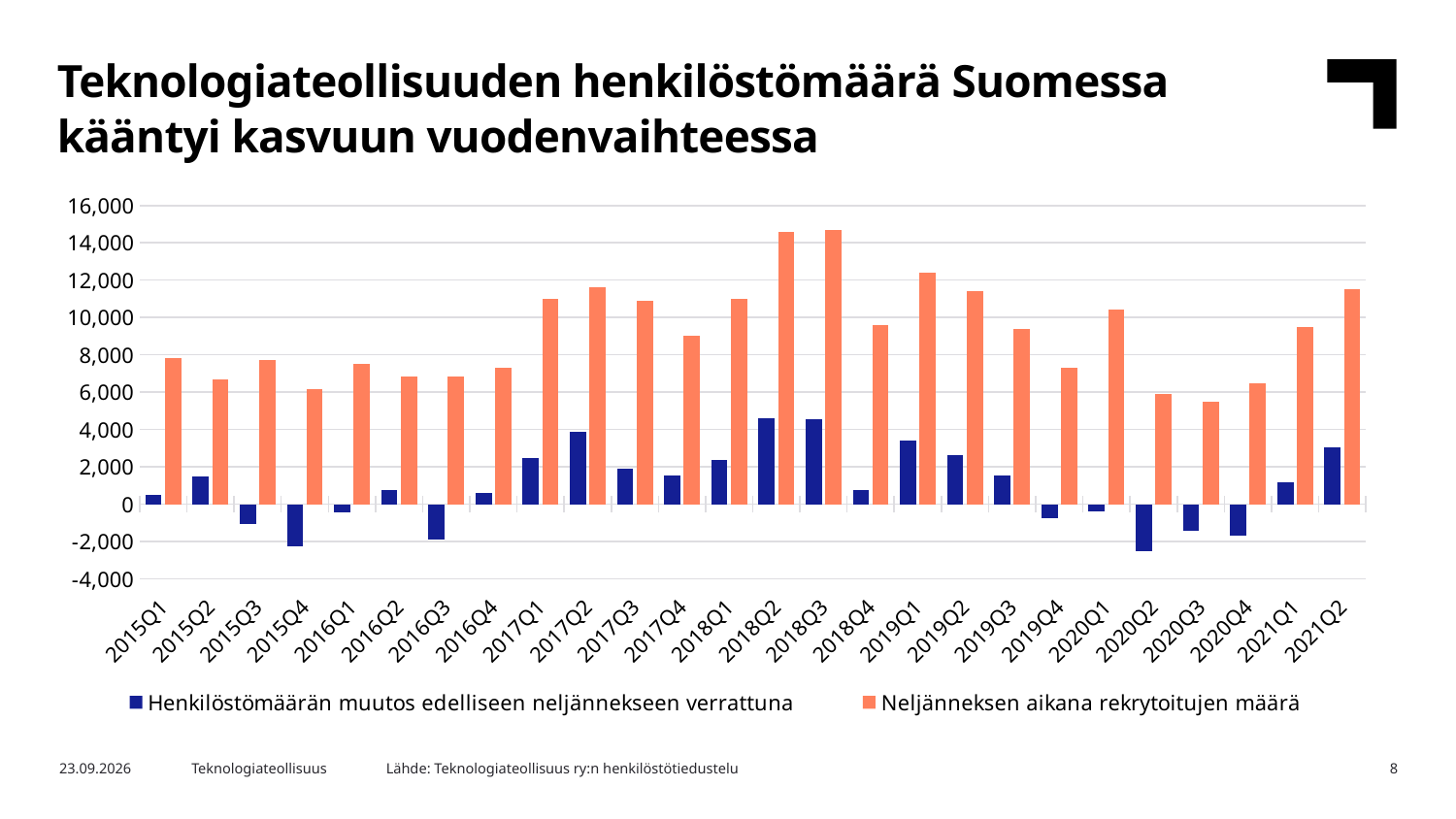
What colour are the bars for 'Neljänneksen aikana rekrytoitujen määrä'? orange Is the value for 'Henkilöstömäärän muutos edelliseen neljännekseen verrattuna' in 2017Q2 greater or less than 2,000? greater How many series does the legend list? 2 Is the value for 'Neljänneksen aikana rekrytoitujen määrä' in 2018Q2 greater or less than 14,000? greater How many quarters are shown on the x axis? 26 What kind of chart is shown on the slide? bar chart Is the value for 'Henkilöstömäärän muutos edelliseen neljännekseen verrattuna' in 2020Q2 greater or less than -2,000? less Does the value for 'Neljänneksen aikana rekrytoitujen määrä' rise or fall from 2020Q3 to 2021Q2? rise Which quarter has the lowest value for 'Henkilöstömäärän muutos edelliseen neljännekseen verrattuna'? 2020Q2 Which quarter has the larger value for 'Neljänneksen aikana rekrytoitujen määrä', 2019Q1 or 2019Q2? 2019Q1 Which quarter has the lowest value for 'Neljänneksen aikana rekrytoitujen määrä'? 2020Q3